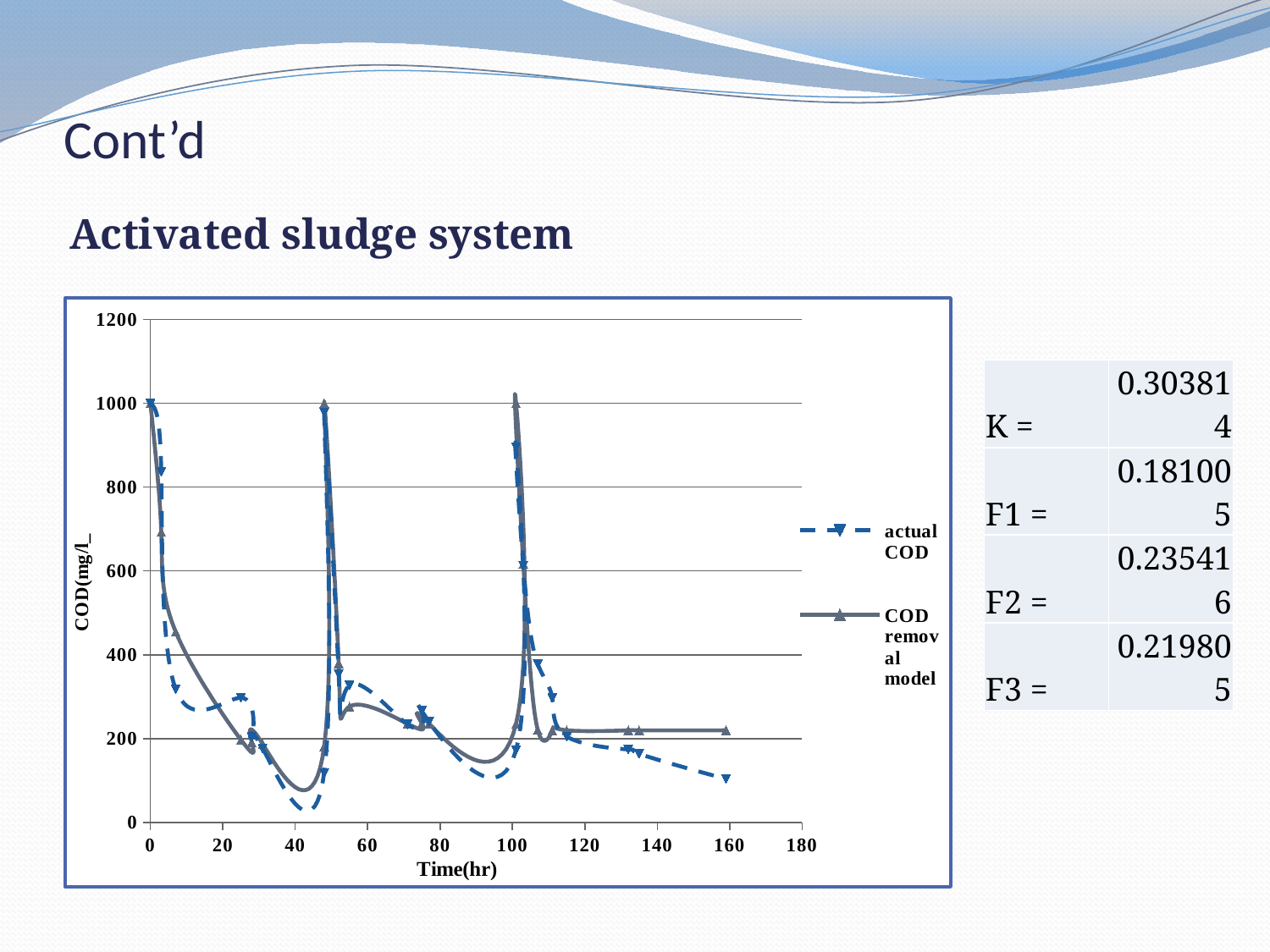
Is the value of actual COD at about 40 hr greater or less than 200? less What are the two series named in the chart legend? actual COD and COD removal model What is the title of the x axis of the chart? Time(hr) How many series does the chart legend list? 2 Between 0 hr and 40 hr, does the actual COD rise or fall? fall Between 120 hr and 160 hr, does the actual COD rise or fall? fall Is the value of actual COD at about 160 hr greater or less than 200? less Is the value of the COD removal model at about 160 hr greater or less than 400? less At about 160 hr, which series has the higher COD value, actual COD or COD removal model? COD removal model What kind of chart is shown on the slide? line chart